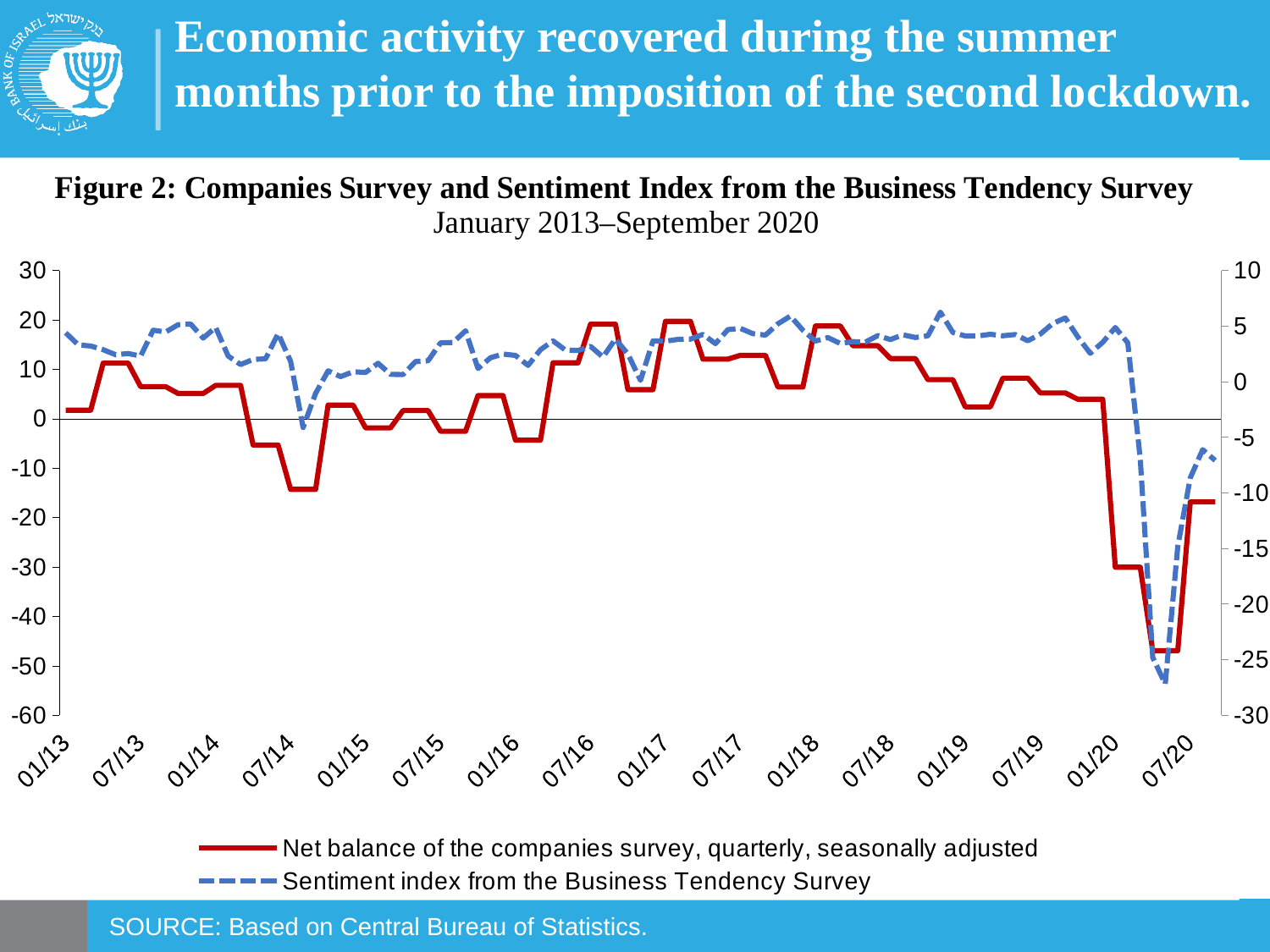
What is the title of the figure on the slide? Figure 2: Companies Survey and Sentiment Index from the Business Tendency Survey Is the lowest value of the net balance of the companies survey in 2014 greater or less than -10 on the left axis? less Which series is drawn as a dashed line? Sentiment index from the Business Tendency Survey What kind of chart is shown on the slide? line chart In which year does the net balance of the companies survey reach its lowest value? 2020 After its trough in 2020, does the net balance of the companies survey rise or fall toward the end of the series? rise How many series does the legend list? 2 Is the value of the sentiment index from the Business Tendency Survey at 01/13 greater or less than 0 on the right axis? greater Is the lowest value of the net balance of the companies survey in 2020 greater or less than -40 on the left axis? less Between 01/13 and 07/13, does the net balance of the companies survey rise or fall? rise